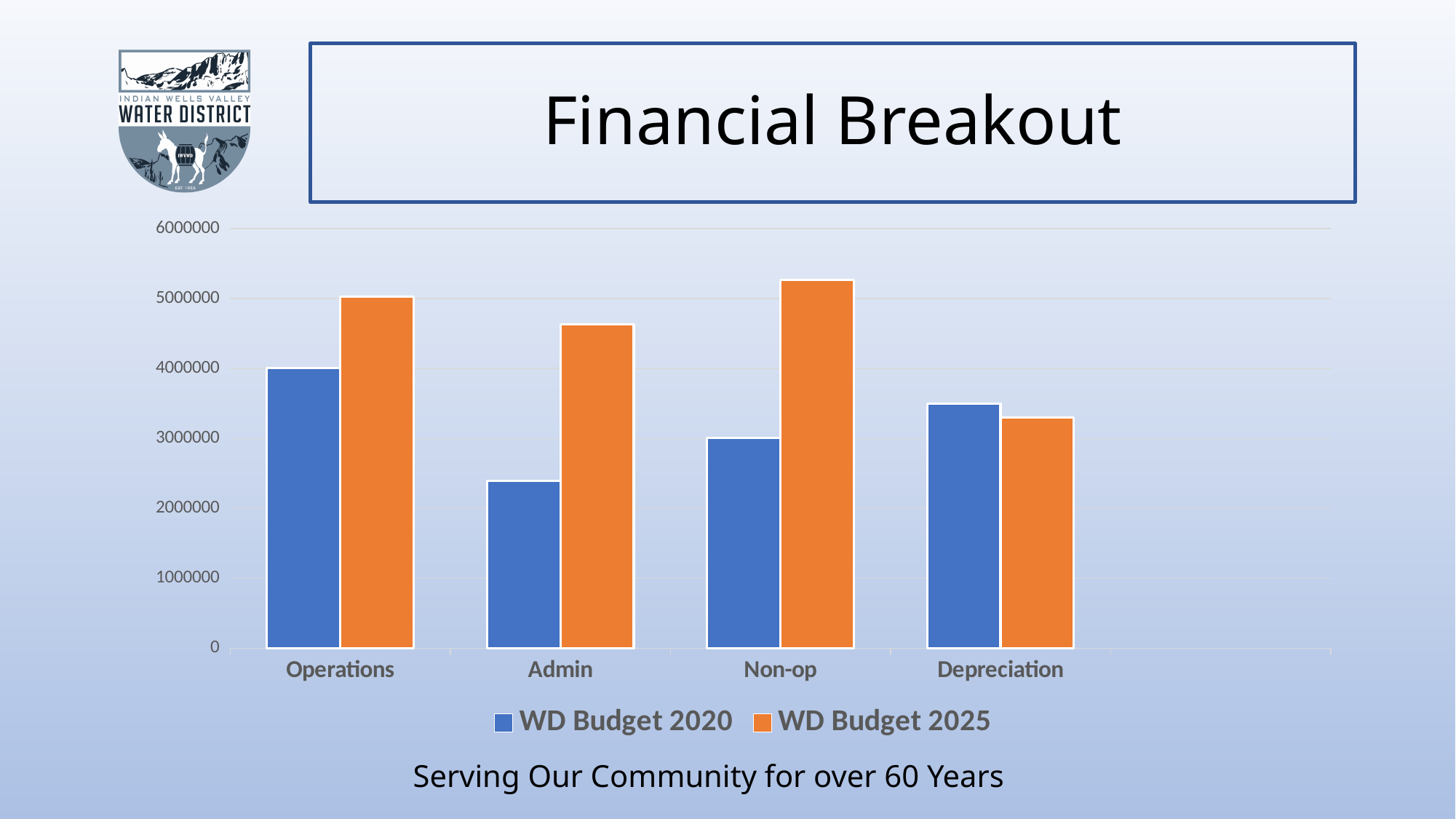
Which series is shown in orange in the chart's legend? WD Budget 2025 Is the WD Budget 2020 value for Admin greater or less than 3000000? less Is the WD Budget 2025 value for Admin greater or less than 4000000? greater How many series does the chart's legend list? 2 How many categories are shown on the x axis of the chart? 4 For Depreciation, which is larger: WD Budget 2020 or WD Budget 2025? WD Budget 2020 Which category has the highest WD Budget 2025 value? Non-op Which category has the lowest WD Budget 2020 value? Admin Is the WD Budget 2025 value for Non-op greater or less than 5000000? greater Which category has the highest WD Budget 2020 value? Operations What kind of chart is shown on the slide? bar chart Which category has the lowest WD Budget 2025 value? Depreciation